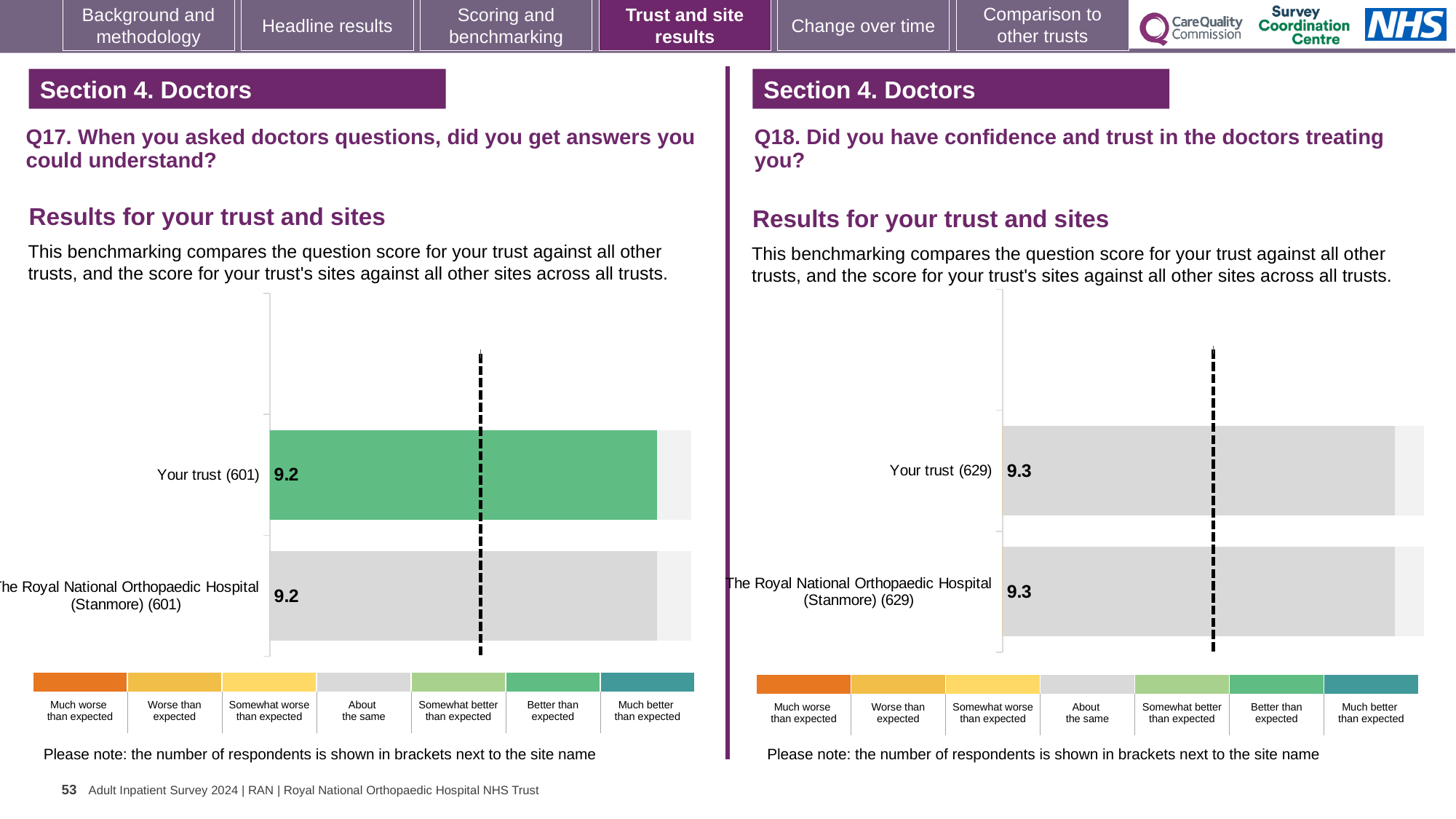
In the Q18 chart on the right, what is the difference between the score for Your trust and the score for The Royal National Orthopaedic Hospital (Stanmore)? 0 In the Q17 chart on the left, what is the score for Your trust (601)? 9.2 In the Q17 chart on the left, what is the score for The Royal National Orthopaedic Hospital (Stanmore) (601)? 9.2 How many bars are plotted in the Q18 chart on the right? 2 What type of chart is used for the Q17 results on the left? Bar chart In the Q18 chart on the right, how many respondents are shown in brackets for The Royal National Orthopaedic Hospital (Stanmore)? 629 In the Q17 chart on the left, how many respondents are shown in brackets for Your trust? 601 In the Q18 chart on the right, what is the score for The Royal National Orthopaedic Hospital (Stanmore) (629)? 9.3 In the Q17 chart on the left, what is the difference between the score for Your trust and the score for The Royal National Orthopaedic Hospital (Stanmore)? 0 How many bars are plotted in the Q17 chart on the left? 2 In the Q18 chart on the right, what is the score for Your trust (629)? 9.3 In the Q17 chart on the left, which benchmark category does the green colour of the Your trust bar correspond to in the key? Better than expected